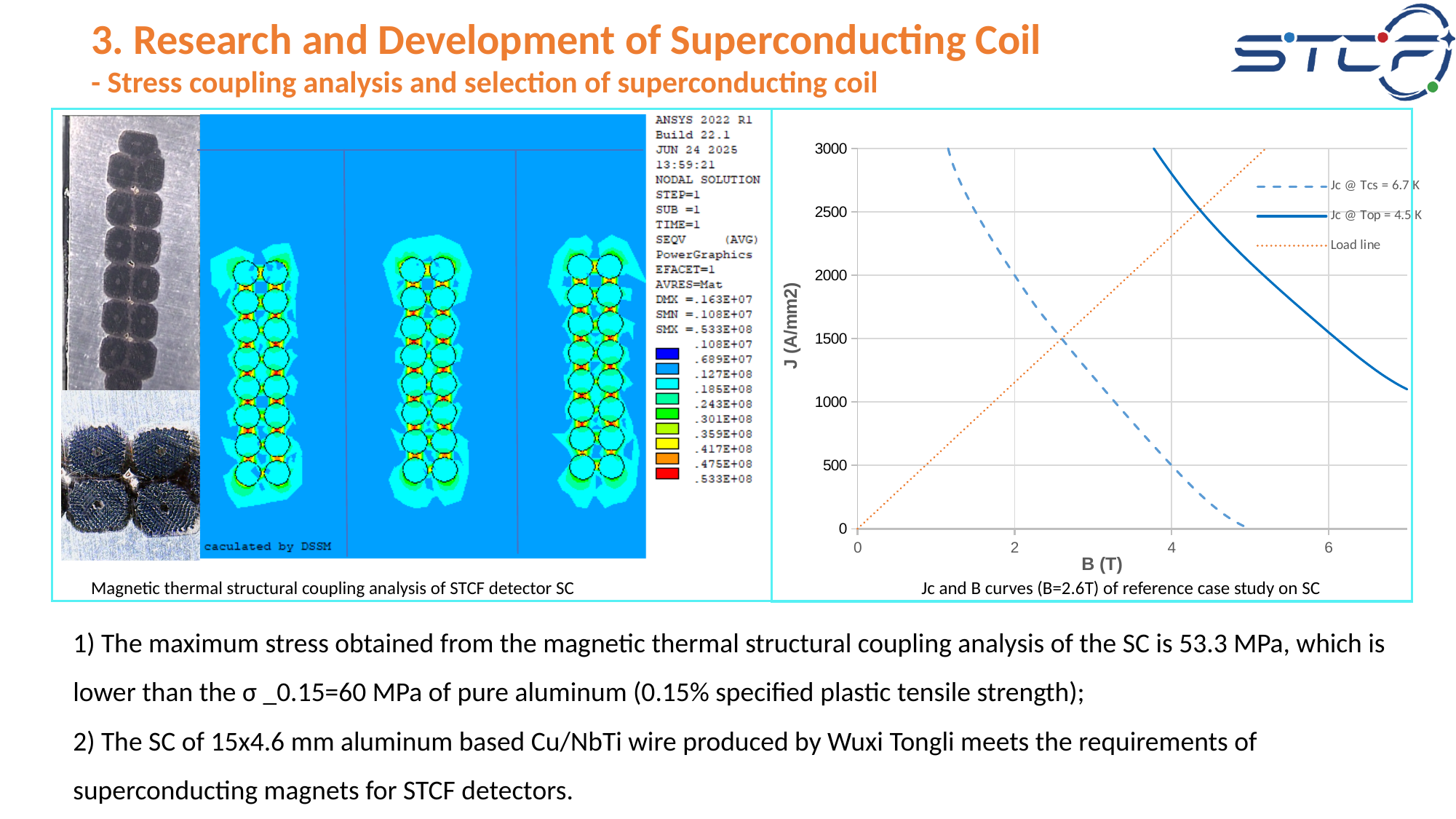
In the Jc and B curves chart, is the value of the Load line at B = 1 T greater or less than 1000? less What kind of chart is shown on the right side of the slide? line chart In the Jc and B curves chart, is the value of the Load line at B = 4 T greater or less than 2000? greater In the Jc and B curves chart, at B = 1 T, which is larger: the Load line or Jc @ Tcs = 6.7 K? Jc @ Tcs = 6.7 K How many series does the legend of the Jc and B curves chart list? 3 In the Jc and B curves chart, does the Jc @ Top = 4.5 K curve rise or fall as B increases? fall In the Jc and B curves chart, is the value of Jc @ Tcs = 6.7 K at B = 4 T greater or less than 1000? less In the Jc and B curves chart, does the Load line rise or fall as B increases? rise What is the label of the x axis of the Jc and B curves chart? B (T) In the Jc and B curves chart, at B = 4 T, which is larger: Jc @ Top = 4.5 K or Jc @ Tcs = 6.7 K? Jc @ Top = 4.5 K In the Jc and B curves chart, which series is drawn with a dashed line? Jc @ Tcs = 6.7 K